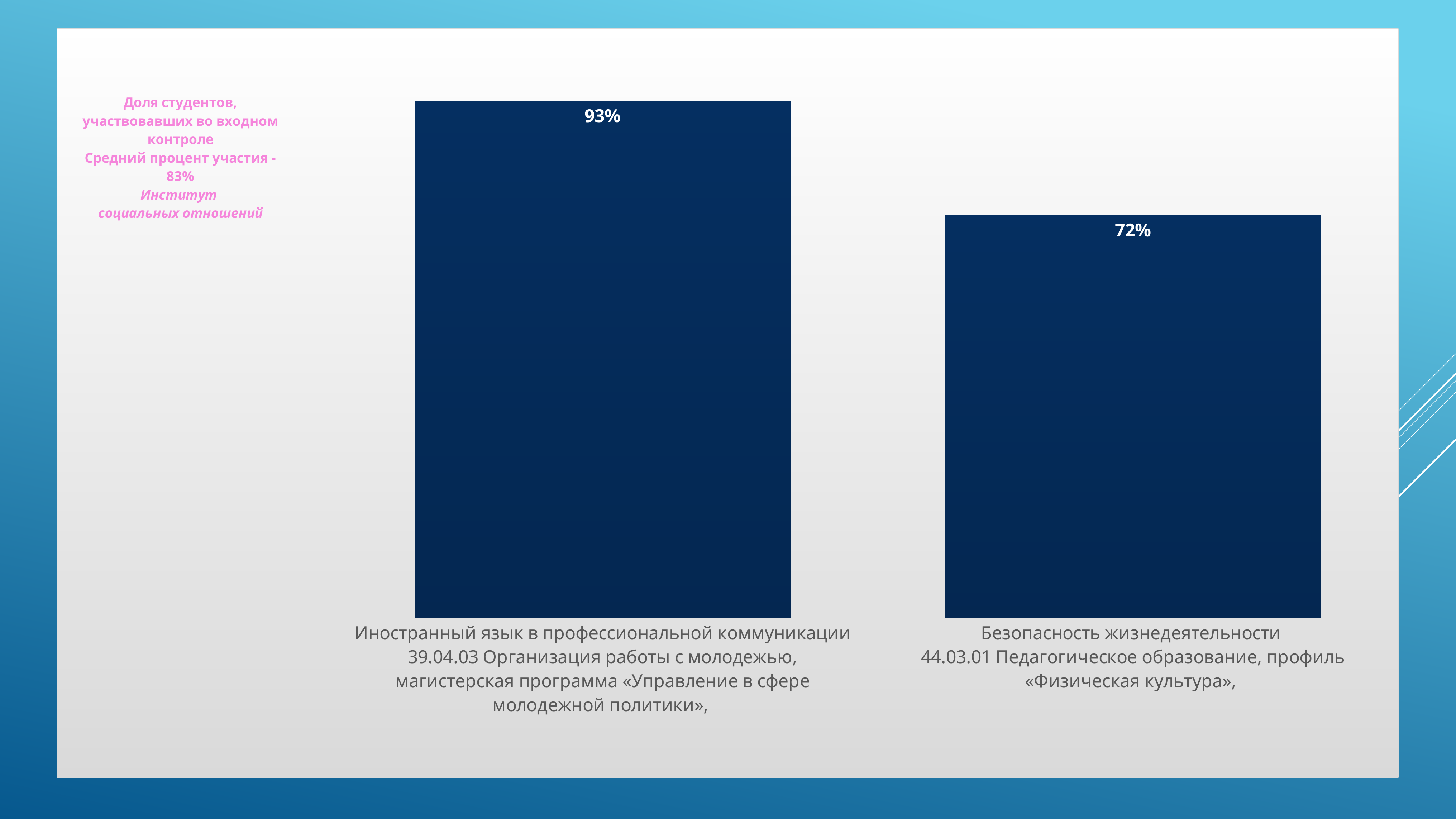
What average participation percentage (Средний процент участия) is stated in the chart's title text? 83% What is the value for «Безопасность жизнедеятельности»? 72% Do the values rise or fall from left to right across the chart? Fall Which category has the lowest value? Безопасность жизнедеятельности Which is larger: the value for «Иностранный язык в профессиональной коммуникации» or for «Безопасность жизнедеятельности»? Иностранный язык в профессиональной коммуникации What is the difference between the values for «Иностранный язык в профессиональной коммуникации» and «Безопасность жизнедеятельности»? 21% How many categories are shown in the chart? 2 What kind of chart is shown on the slide? Bar chart Which category has the highest value? Иностранный язык в профессиональной коммуникации Which institute is named in the chart's title text? Институт социальных отношений What is the value for «Иностранный язык в профессиональной коммуникации»? 93%